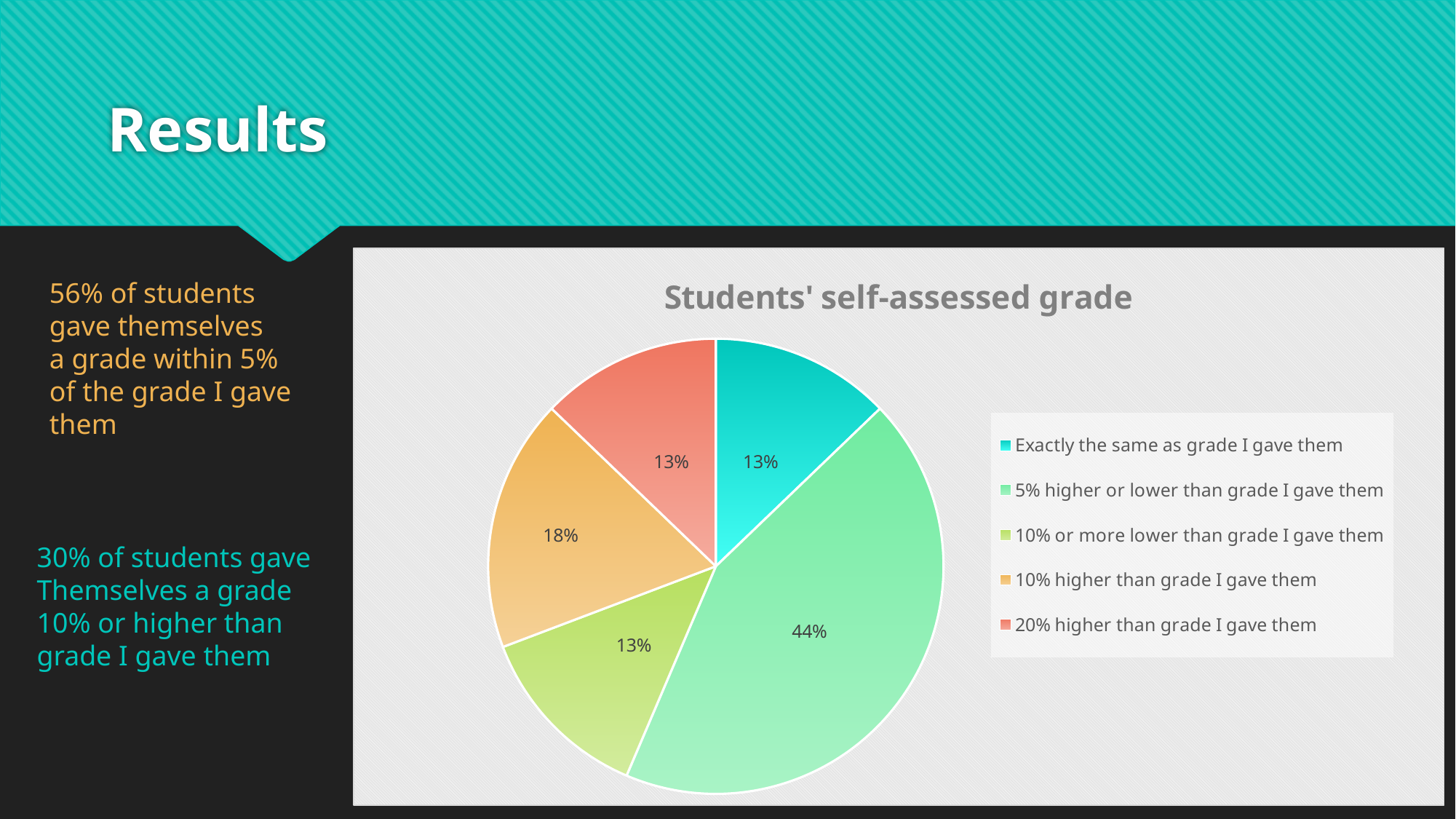
What type of chart is shown on the slide? pie chart Which is larger: the share for '10% higher than grade I gave them' or the share for '20% higher than grade I gave them'? 10% higher than grade I gave them What is the difference between the share for '5% higher or lower than grade I gave them' and the share for '10% higher than grade I gave them'? 26% What is the title of the chart? Students' self-assessed grade How many categories does the legend list? 5 What share of students gave themselves a grade 10% or more lower than the grade the teacher gave them? 13% What share of students gave themselves a grade 20% higher than the grade the teacher gave them? 13% Which category has the largest slice of the pie? 5% higher or lower than grade I gave them What share of students gave themselves exactly the same grade as the teacher gave them? 13% What share of students gave themselves a grade 5% higher or lower than the grade the teacher gave them? 44% What share of students gave themselves a grade 10% higher than the grade the teacher gave them? 18% What colour is the slice for '20% higher than grade I gave them'? red